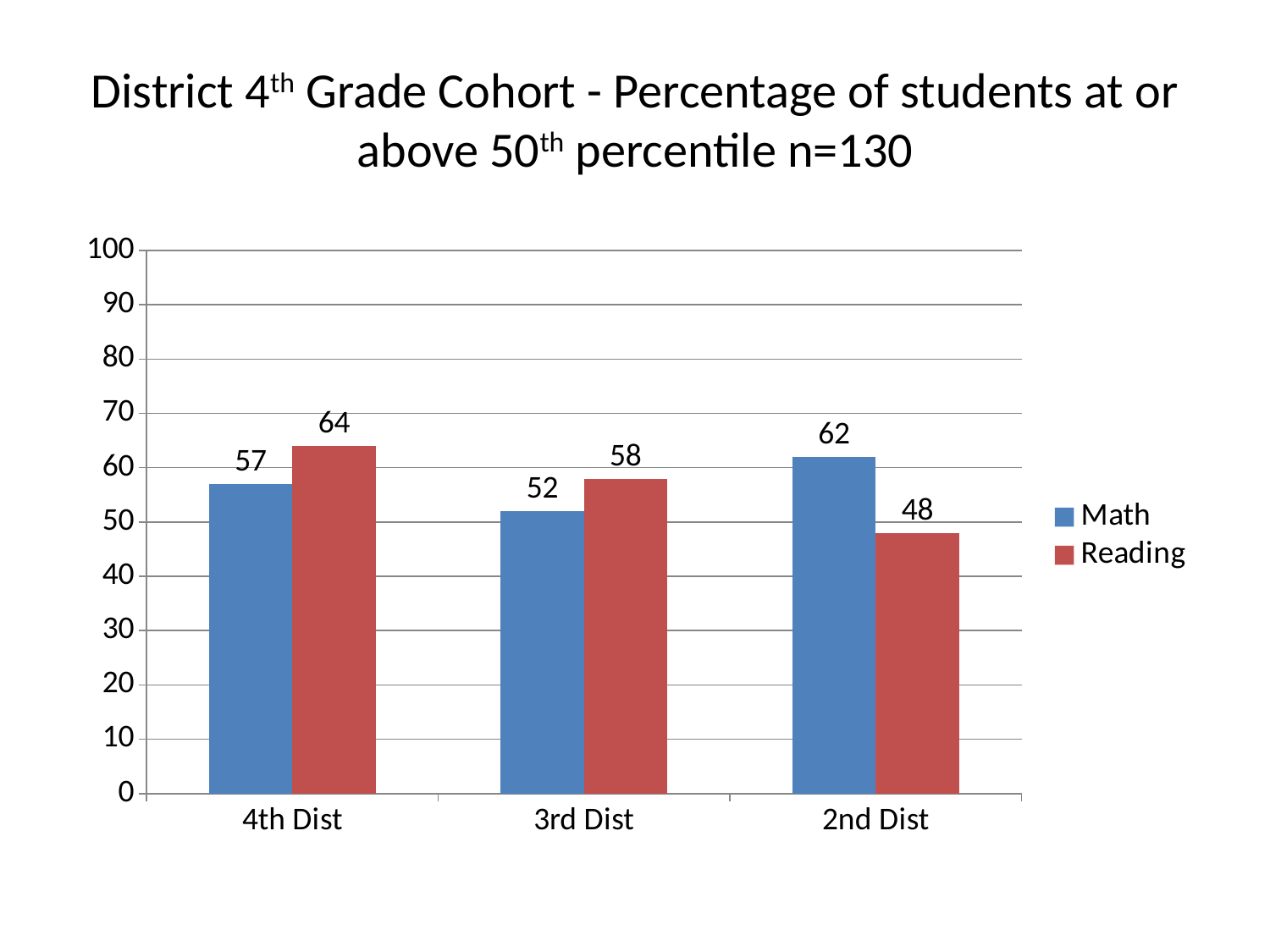
Which category has the lowest Math value? 3rd Dist Is the Math value for 2nd Dist greater or less than 50? greater What kind of chart is shown on the slide? bar chart Which is larger for 2nd Dist, Math or Reading? Math How many series does the legend list? 2 How many categories are shown on the x axis? 3 What is the difference between the Reading and Math values for 4th Dist? 7 Which colour represents the Reading series? red What is the Reading value for 2nd Dist? 48 What is the Reading value for 3rd Dist? 58 What is the Math value for 4th Dist? 57 Which category has the highest Reading value? 4th Dist